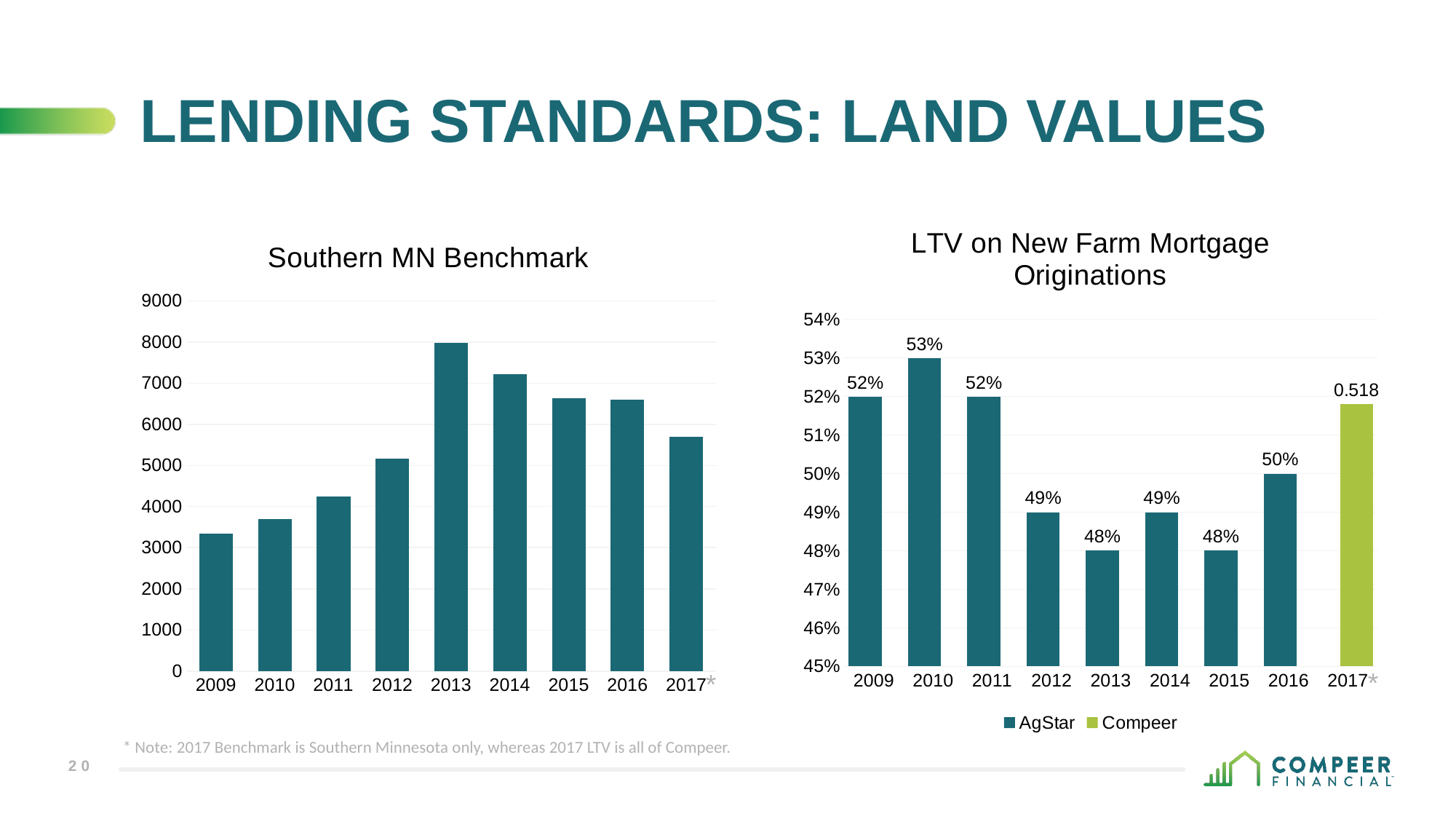
In the Southern MN Benchmark chart, which year has the highest value? 2013 In the Southern MN Benchmark chart, which year has the lowest value? 2009 In the LTV on New Farm Mortgage Originations chart, what is the value for 2010? 53% In the LTV on New Farm Mortgage Originations chart, which is larger, the value for 2012 or the value for 2016? 2016 In the Southern MN Benchmark chart, is the value for 2017 greater or less than 6000? less How many series does the legend of the LTV on New Farm Mortgage Originations chart list? 2 In the Southern MN Benchmark chart, is the value for 2009 greater or less than 4000? less In the LTV on New Farm Mortgage Originations chart, what is the value for 2017? 0.518 In the LTV on New Farm Mortgage Originations chart, what is the difference between the 2010 value and the 2013 value? 5% How many years are shown on the x axis of the Southern MN Benchmark chart? 9 In the Southern MN Benchmark chart, is the value for 2013 greater or less than 7000? greater What type of chart is the Southern MN Benchmark chart? bar chart